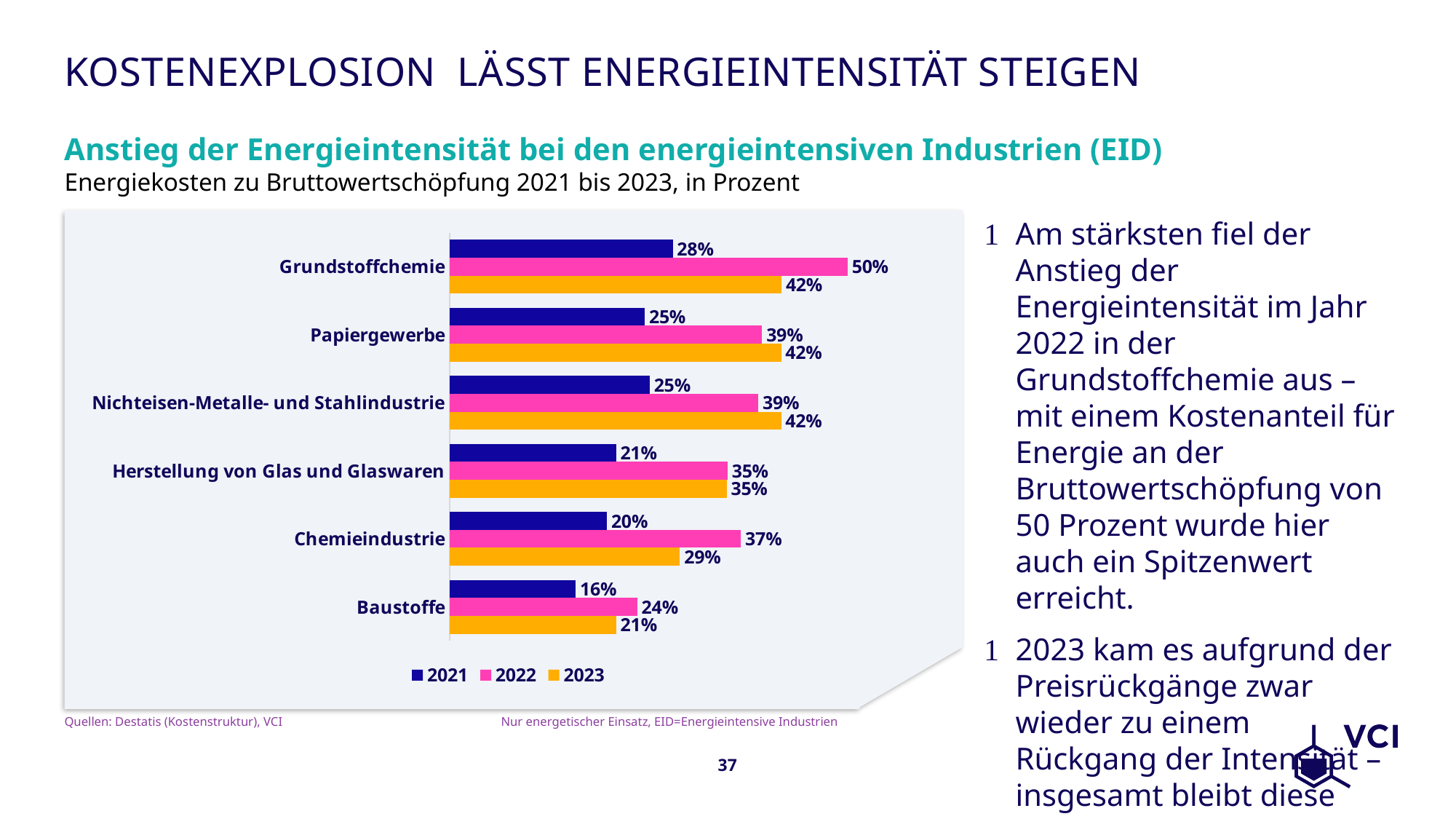
Which colour represents the 2023 series in the legend? Orange What kind of chart is shown on the slide? Bar chart Which category has the lowest value in 2021? Baustoffe What is the difference between the 2023 values for Papiergewerbe and Baustoffe? 21% What is the difference between the 2022 and 2021 values for Grundstoffchemie? 22% How many categories are shown on the chart? 6 What is the value for Chemieindustrie in 2023? 29% How many series does the legend list? 3 What is the value for Grundstoffchemie in 2022? 50% What is the value for Baustoffe in 2021? 16% Which is larger for Chemieindustrie: the 2022 value or the 2023 value? 2022 Which category has the highest value in 2022? Grundstoffchemie